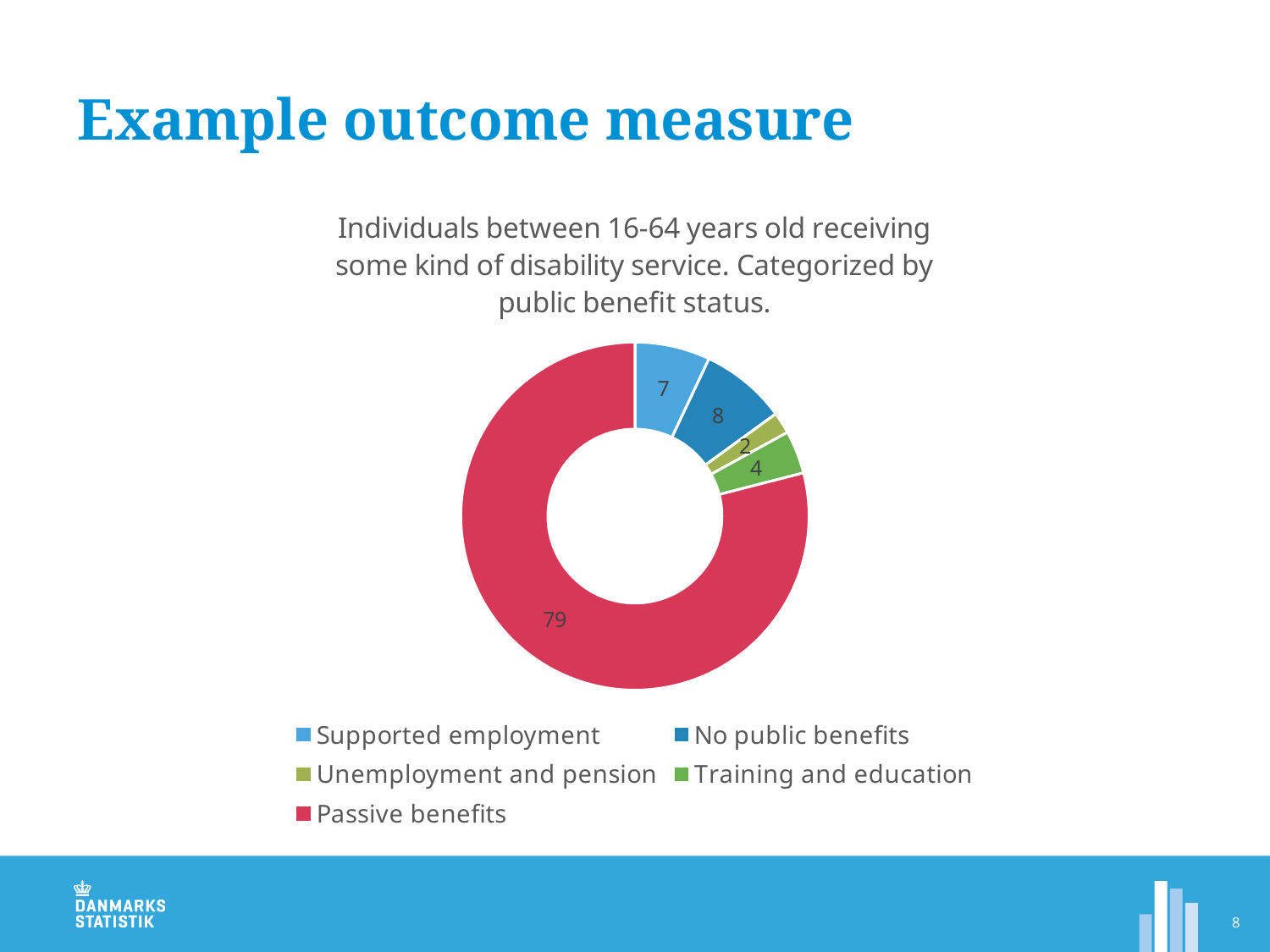
Which is larger, the value for No public benefits or the value for Supported employment? No public benefits What is the value for Unemployment and pension? 2 What is the value for Supported employment? 7 Which category has the smallest value? Unemployment and pension What is the difference between the values for Passive benefits and No public benefits? 71 How many categories does the chart show? 5 Which category has the largest value? Passive benefits What colour is the Passive benefits segment? Red What is the value for Training and education? 4 What is the value for Passive benefits? 79 What kind of chart is shown on the slide? Doughnut chart What is the value for No public benefits? 8